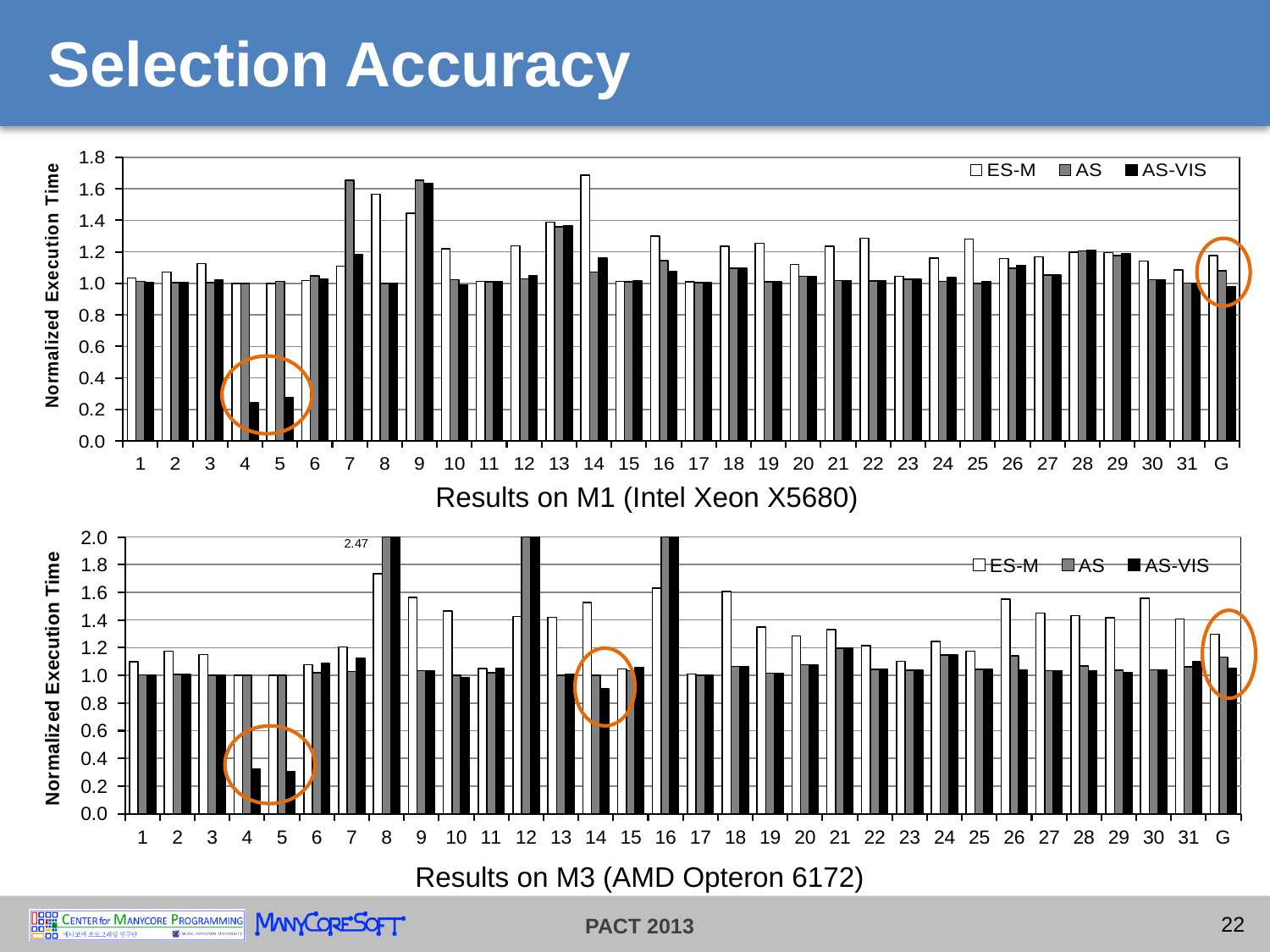
What are the three series named in the legend of the bottom chart, 'Results on M3 (AMD Opteron 6172)'? ES-M, AS, AS-VIS In the bottom chart, 'Results on M3 (AMD Opteron 6172)', what value is printed as a data label above the bars at category 8? 2.47 How many categories are shown on the x axis of the bottom chart, 'Results on M3 (AMD Opteron 6172)'? 32 In the bottom chart, 'Results on M3 (AMD Opteron 6172)', for category 26, which is larger: the ES-M value or the AS-VIS value? ES-M In the top chart, 'Results on M1 (Intel Xeon X5680)', is the AS value for category 7 greater or less than 1.4? greater What kind of chart is the top chart, 'Results on M1 (Intel Xeon X5680)'? bar chart In the bottom chart, 'Results on M3 (AMD Opteron 6172)', is the ES-M value for category 8 greater or less than 1.6? greater How many series does the legend of the top chart list? 3 In the top chart, 'Results on M1 (Intel Xeon X5680)', is the AS-VIS value for category 4 greater or less than 0.5? less In the top chart, 'Results on M1 (Intel Xeon X5680)', which category has the highest ES-M value? 14 In the top chart, 'Results on M1 (Intel Xeon X5680)', for category 7, which is larger: the ES-M value or the AS value? AS